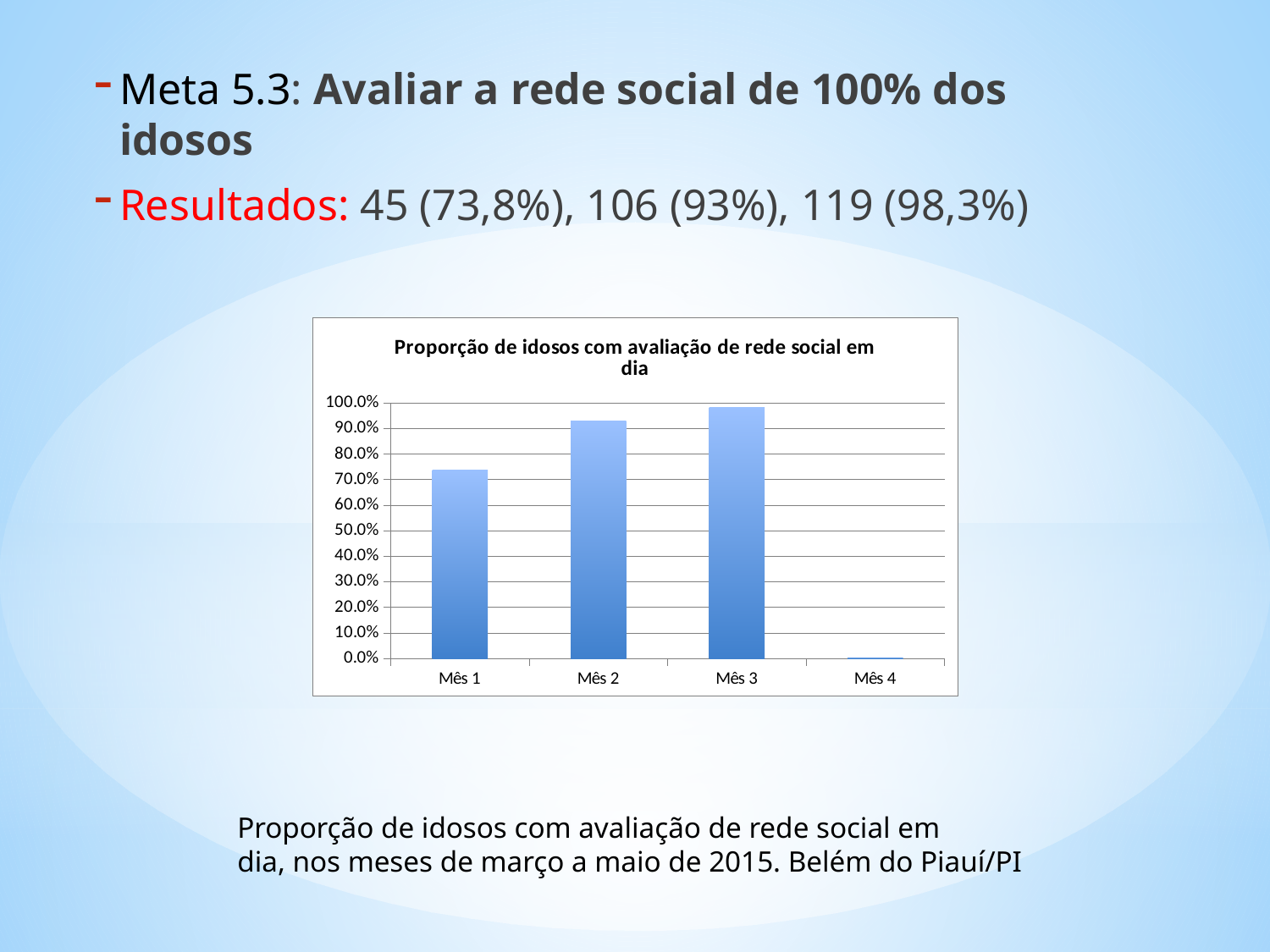
From Mês 1 to Mês 3, do the values rise or fall? rise What is the title of the chart? Proporção de idosos com avaliação de rede social em dia Is the value for Mês 1 greater or less than 80.0%? less How many categories (months) are shown on the x axis of the chart? 4 Which month has the highest bar in the chart? Mês 3 Which month has the lowest bar in the chart? Mês 4 Is the value for Mês 1 greater or less than 70.0%? greater Which is larger, the value for Mês 1 or the value for Mês 2? Mês 2 Is the value for Mês 2 greater or less than 90.0%? greater What kind of chart is shown on the slide? bar chart